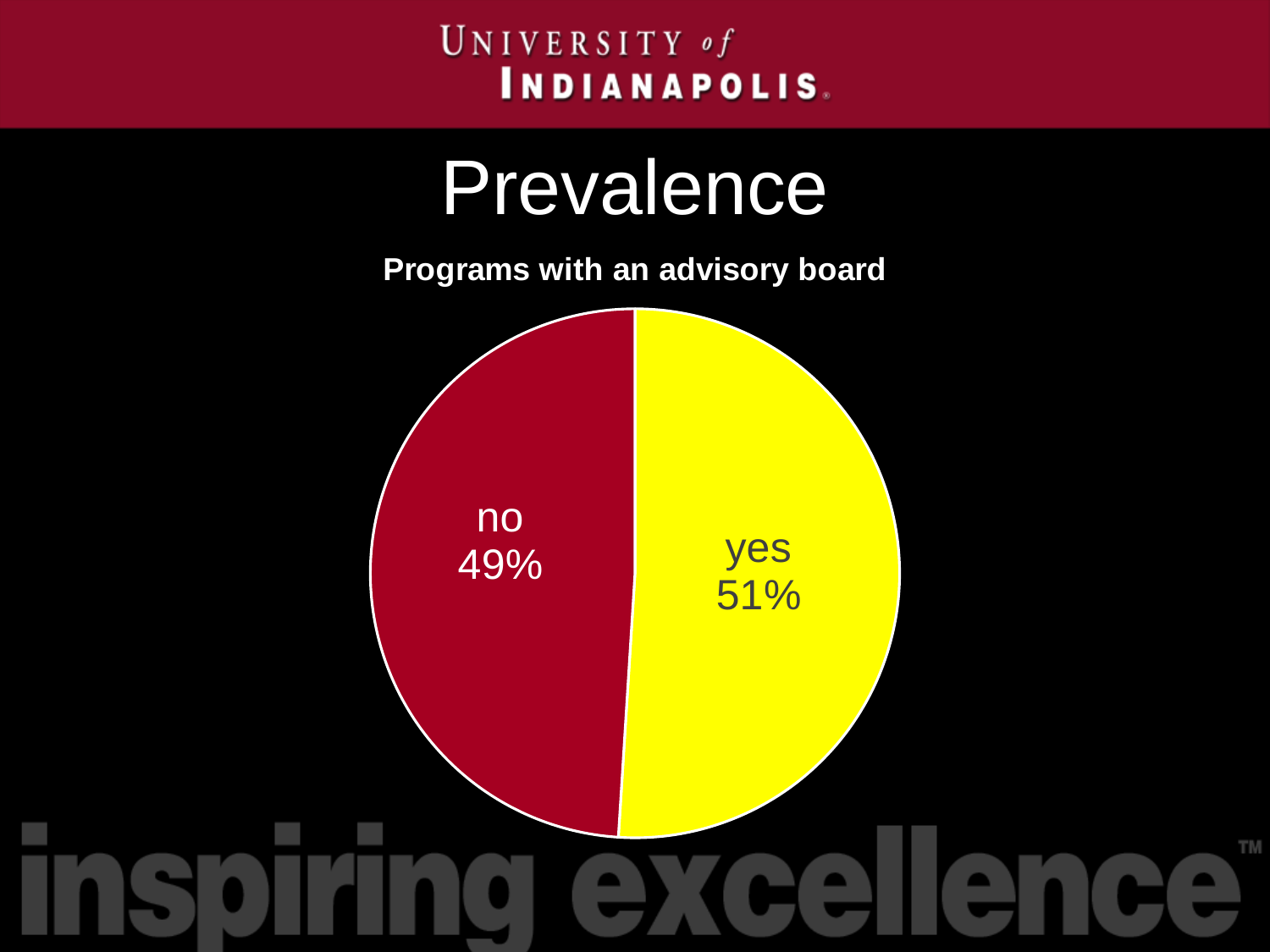
How many slices does the pie chart have? 2 What percentage of programs answered "yes" to having an advisory board? 51% What colour is the "no" slice of the pie? red What is the difference in percentage points between the "yes" and "no" slices? 2 What percentage of programs answered "no" to having an advisory board? 49% What share of the pie does the "yes" slice represent? 51% Which slice of the pie is the smallest? no Which slice of the pie is the largest? yes Which is larger, the "yes" slice or the "no" slice? yes What is the title of the chart? Programs with an advisory board What type of chart is shown on the slide? pie chart